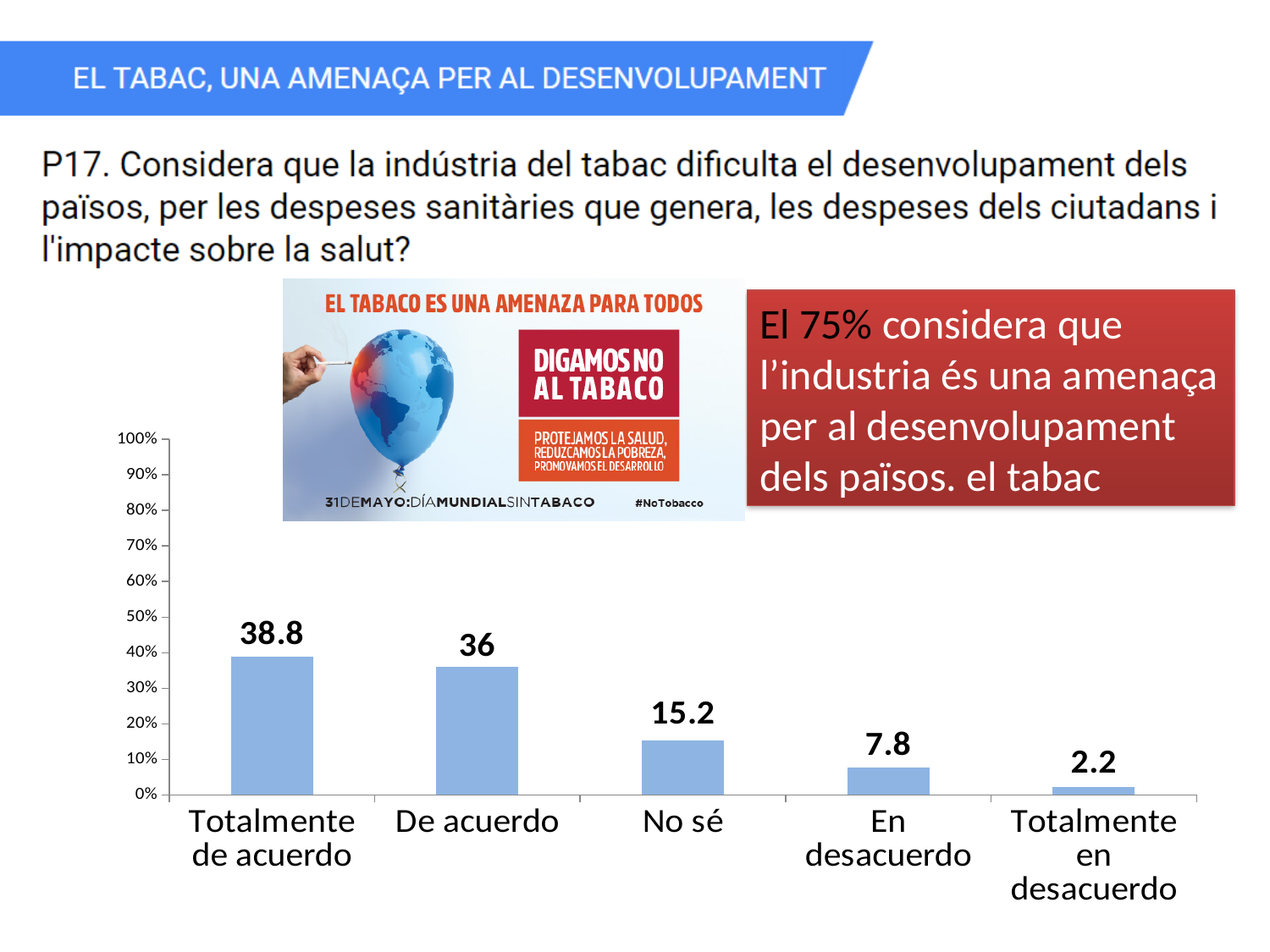
How many categories are shown on the x axis? 5 What is the value for "Totalmente de acuerdo"? 38.8 What is the value for "No sé"? 15.2 Which category has the highest value? Totalmente de acuerdo What is the difference between the values for "Totalmente de acuerdo" and "De acuerdo"? 2.8 Which is larger, the value for "No sé" or the value for "En desacuerdo"? No sé Which category has the lowest value? Totalmente en desacuerdo What is the value for "De acuerdo"? 36 What is the value for "Totalmente en desacuerdo"? 2.2 Do the values rise or fall from left to right along the x axis? Fall What is the value for "En desacuerdo"? 7.8 What kind of chart is shown on the slide? Bar chart